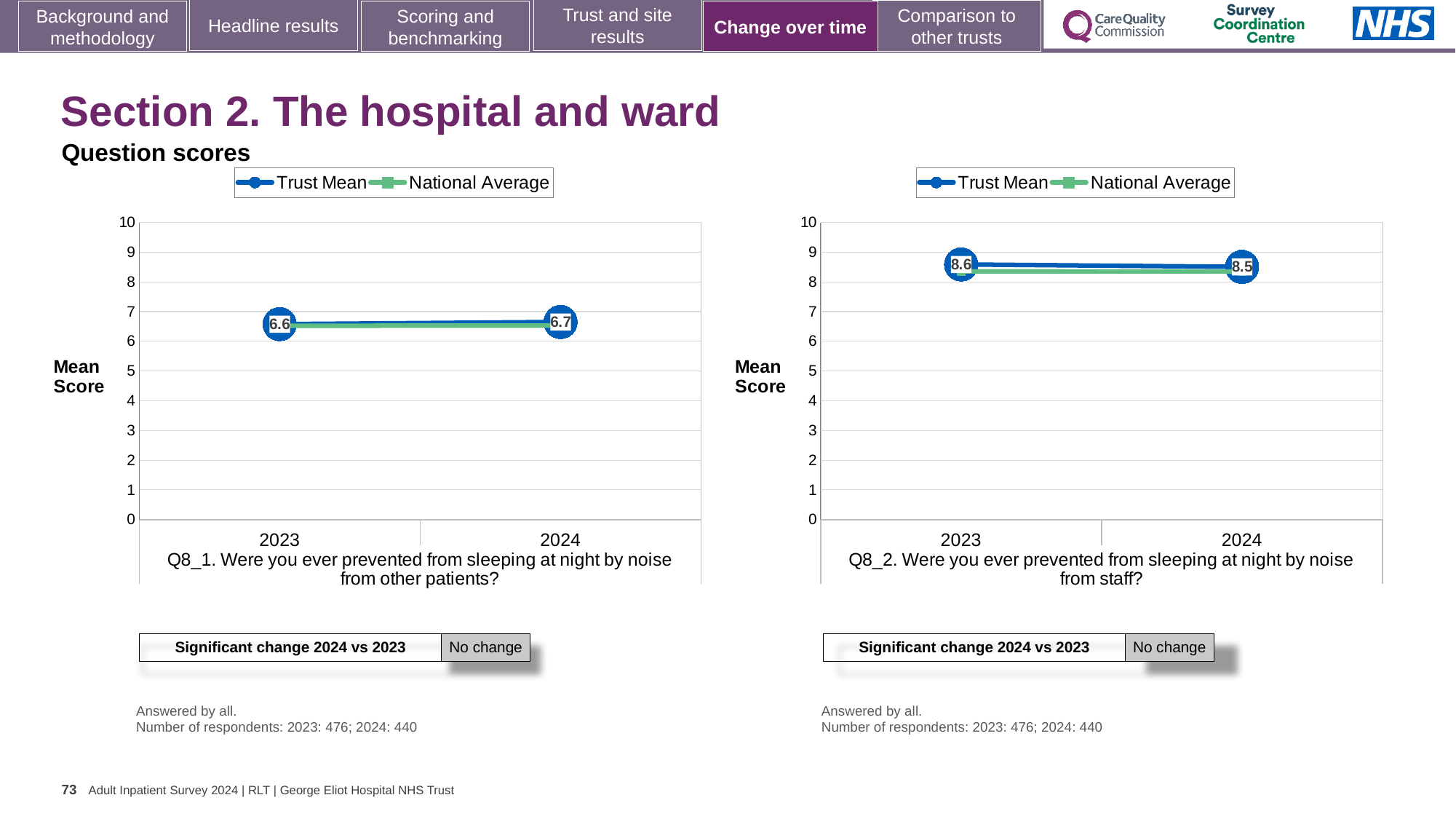
How many series does the legend of the Q8_2 chart (right) list? 2 On the Q8_1 chart (left), what is the Trust Mean for 2023? 6.6 On the Q8_2 chart (right), what is the Trust Mean for 2024? 8.5 On the Q8_2 chart (right), does the Trust Mean rise or fall from 2023 to 2024? fall On the Q8_2 chart (right), is the Trust Mean for 2023 greater or less than 8? greater On the Q8_1 chart (left), does the Trust Mean rise or fall from 2023 to 2024? rise On the Q8_2 chart (right), which year has the higher Trust Mean, 2023 or 2024? 2023 On the Q8_1 chart (left), what is the difference between the Trust Mean for 2024 and 2023? 0.1 On the Q8_2 chart (right), what is the Trust Mean for 2023? 8.6 On the Q8_1 chart (left), what is the Trust Mean for 2024? 6.7 How many years are plotted on the x axis of the Q8_1 chart (left)? 2 What kind of chart is the Q8_1 chart (left)? line chart